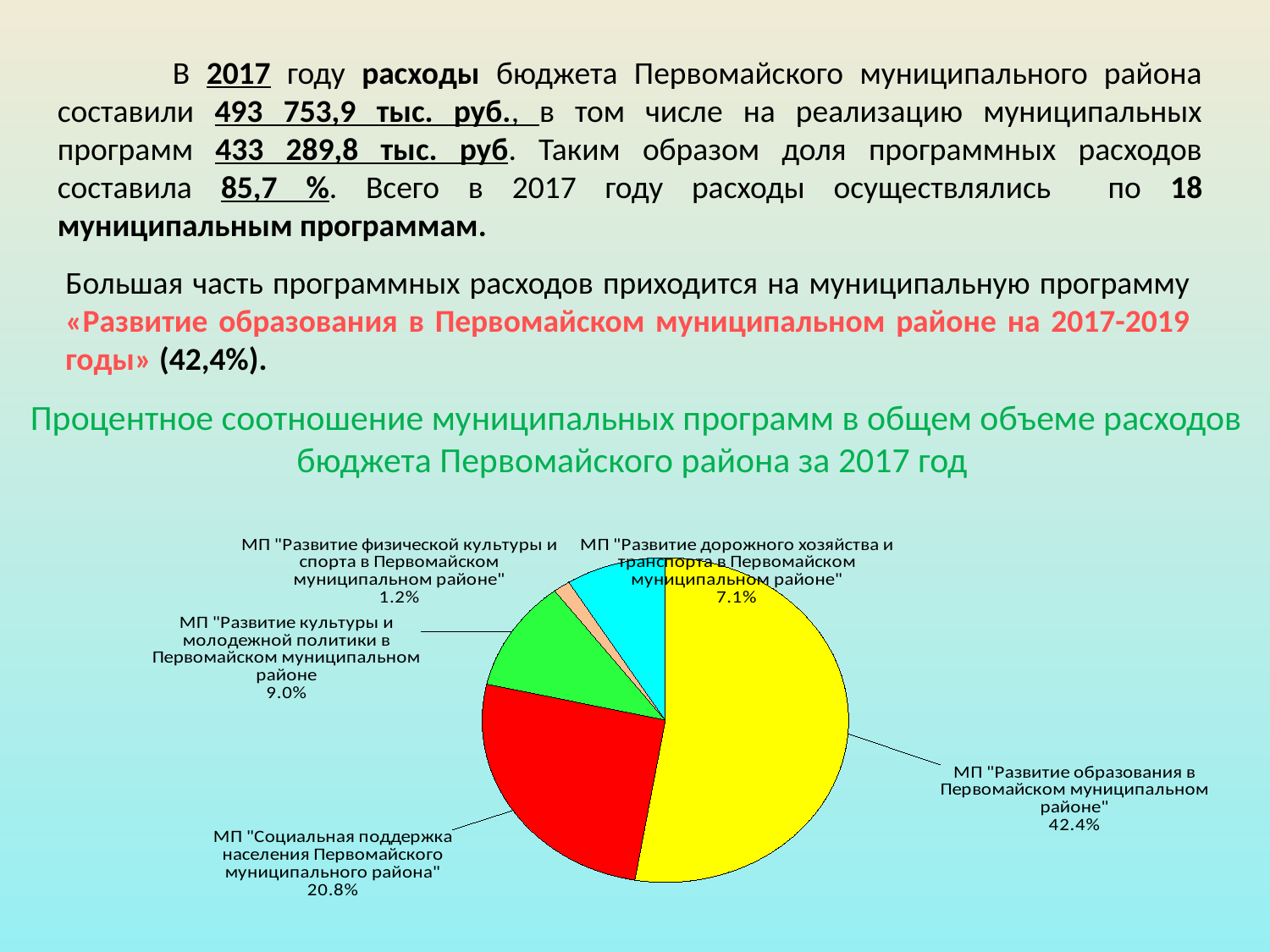
What percentage is shown for the program "Социальная поддержка населения Первомайского муниципального района"? 20.8% Which has a larger share: the culture and youth policy program or the road economy and transport program? Culture and youth policy program What percentage is shown for the program "Развитие дорожного хозяйства и транспорта в Первомайском муниципальном районе"? 7.1% What share of the pie does the program "Развитие образования в Первомайском муниципальном районе" have? 42.4% Which labeled program has the largest share of the pie? МП "Развитие образования в Первомайском муниципальном районе" What is the title of the chart? Процентное соотношение муниципальных программ в общем объеме расходов бюджета Первомайского района за 2017 год What percentage is shown for the program "Развитие физической культуры и спорта в Первомайском муниципальном районе"? 1.2% What percentage is shown for the program "Развитие культуры и молодежной политики в Первомайском муниципальном районе"? 9.0% What kind of chart is shown on the slide? Pie chart Which labeled program has the smallest share of the pie? МП "Развитие физической культуры и спорта в Первомайском муниципальном районе" By how many percentage points does the education program's share exceed the social support program's share? 21.6 What is the difference in percentage points between the culture and youth policy program (9.0%) and the road economy and transport program (7.1%)? 1.9